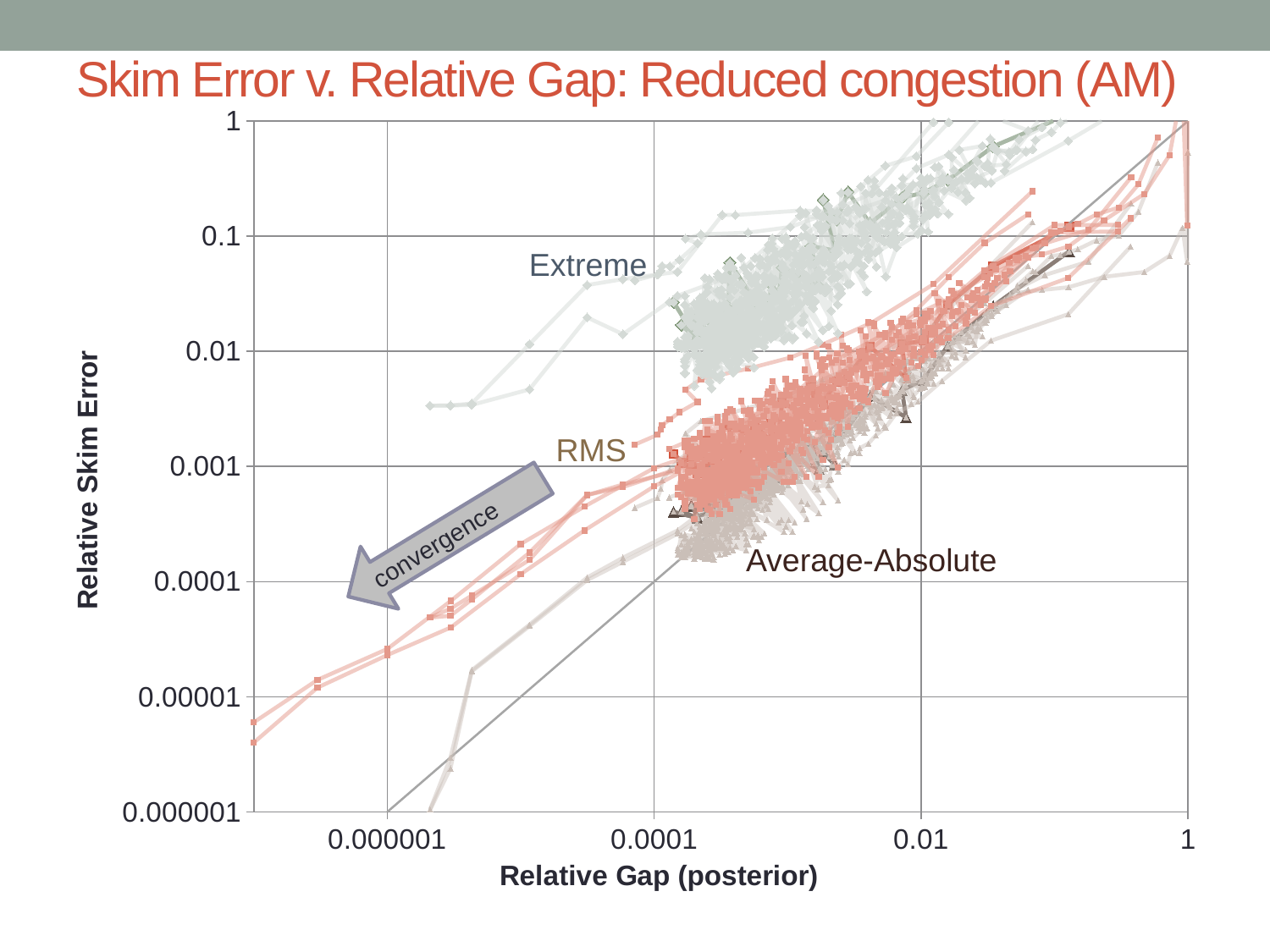
What is the title of the chart? Skim Error v. Relative Gap: Reduced congestion (AM) How many labeled series (groups of points) are shown on the chart? 3 What word is written on the large arrow pointing toward the lower left of the chart? convergence At the same relative gap, which series shows a larger relative skim error, Extreme or RMS? Extreme What kind of chart is shown on the slide? scatter plot Which labeled series lies highest on the chart, with the largest relative skim error for a given relative gap? Extreme Which labeled series lies lowest on the chart, with the smallest relative skim error for a given relative gap? Average-Absolute As the relative gap increases along the x axis, does the relative skim error rise or fall? rise